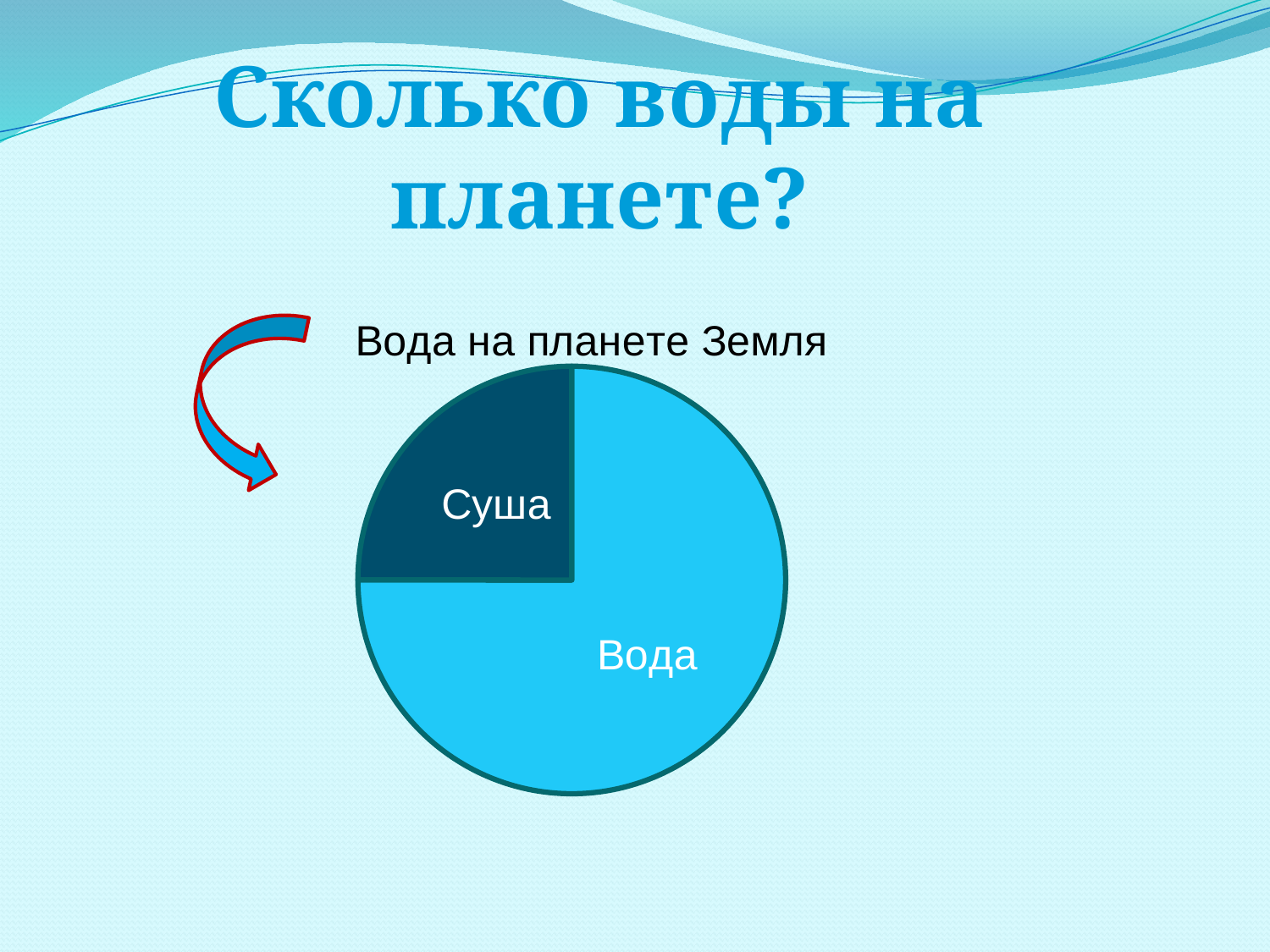
Does the Вода slice take up more or less than half of the pie? more How many slices does the pie chart have? 2 What kind of chart is shown on the slide? pie chart What is the title of the chart? Вода на планете Земля What are the labels of the two slices in the pie chart? Суша and Вода Which slice of the pie chart is the smallest? Суша Which is larger in the pie chart, Вода or Суша? Вода Which slice of the pie chart is the largest? Вода